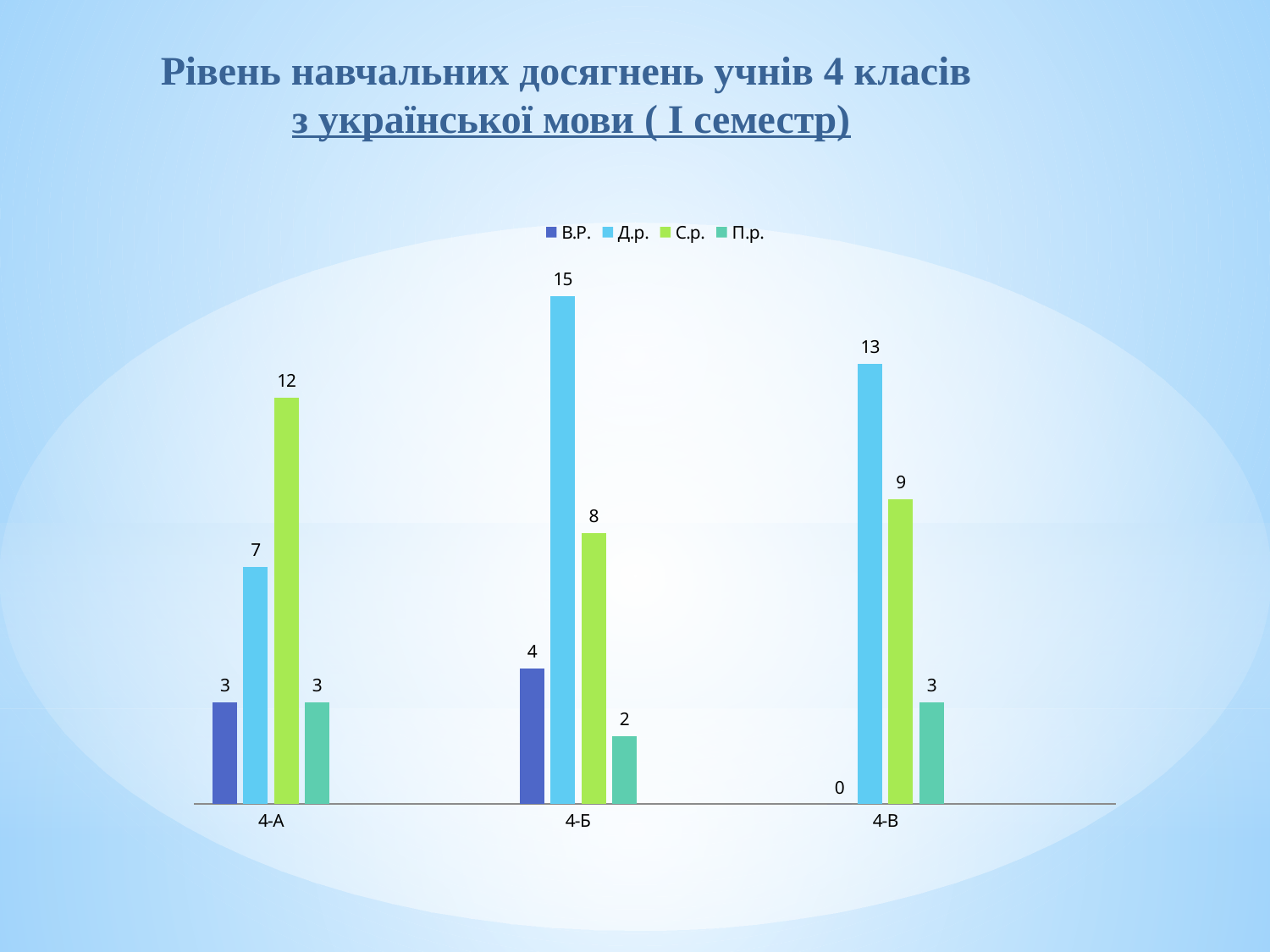
What is the difference between the Д.р. values for 4-Б and 4-А? 8 Which class has the highest Д.р. value? 4-Б What is the value of Д.р. for class 4-Б? 15 Which is larger: С.р. for 4-А or С.р. for 4-В? С.р. for 4-А What is the value of В.Р. for class 4-В? 0 What is the total of all four values for class 4-А? 25 Which class has the lowest С.р. value? 4-Б How many classes (categories) are shown on the x axis? 3 What is the value of П.р. for class 4-Б? 2 What is the value of С.р. for class 4-А? 12 What kind of chart is shown on the slide? Bar chart How many series does the legend list? 4